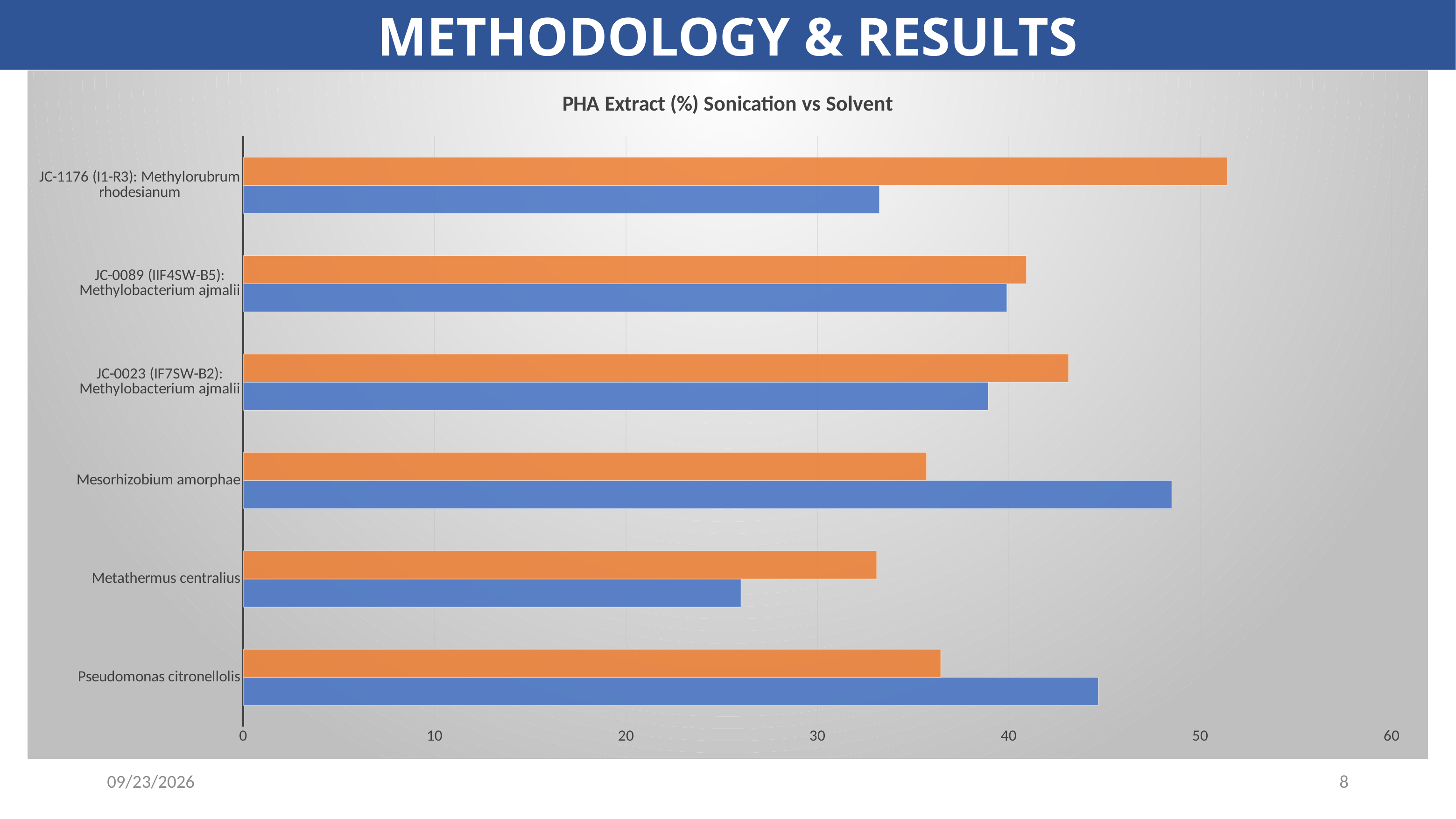
Which category has the shortest blue bar? Metathermus centralius How many bars are plotted for each category in the chart? 2 For Metathermus centralius, which bar is longer, the orange bar or the blue bar? orange bar Which category has the longest blue bar? Mesorhizobium amorphae What is the maximum value shown on the horizontal axis of the chart? 60 Is the orange bar for JC-1176 (I1-R3): Methylorubrum rhodesianum greater or less than 50? greater How many categories (organisms) are listed on the vertical axis of the chart? 6 For Mesorhizobium amorphae, which bar is longer, the orange bar or the blue bar? blue bar Is the blue bar for Metathermus centralius greater or less than 30? less Which category has the longest orange bar? JC-1176 (I1-R3): Methylorubrum rhodesianum What kind of chart is shown on the slide? bar chart What is the title of the chart? PHA Extract (%) Sonication vs Solvent